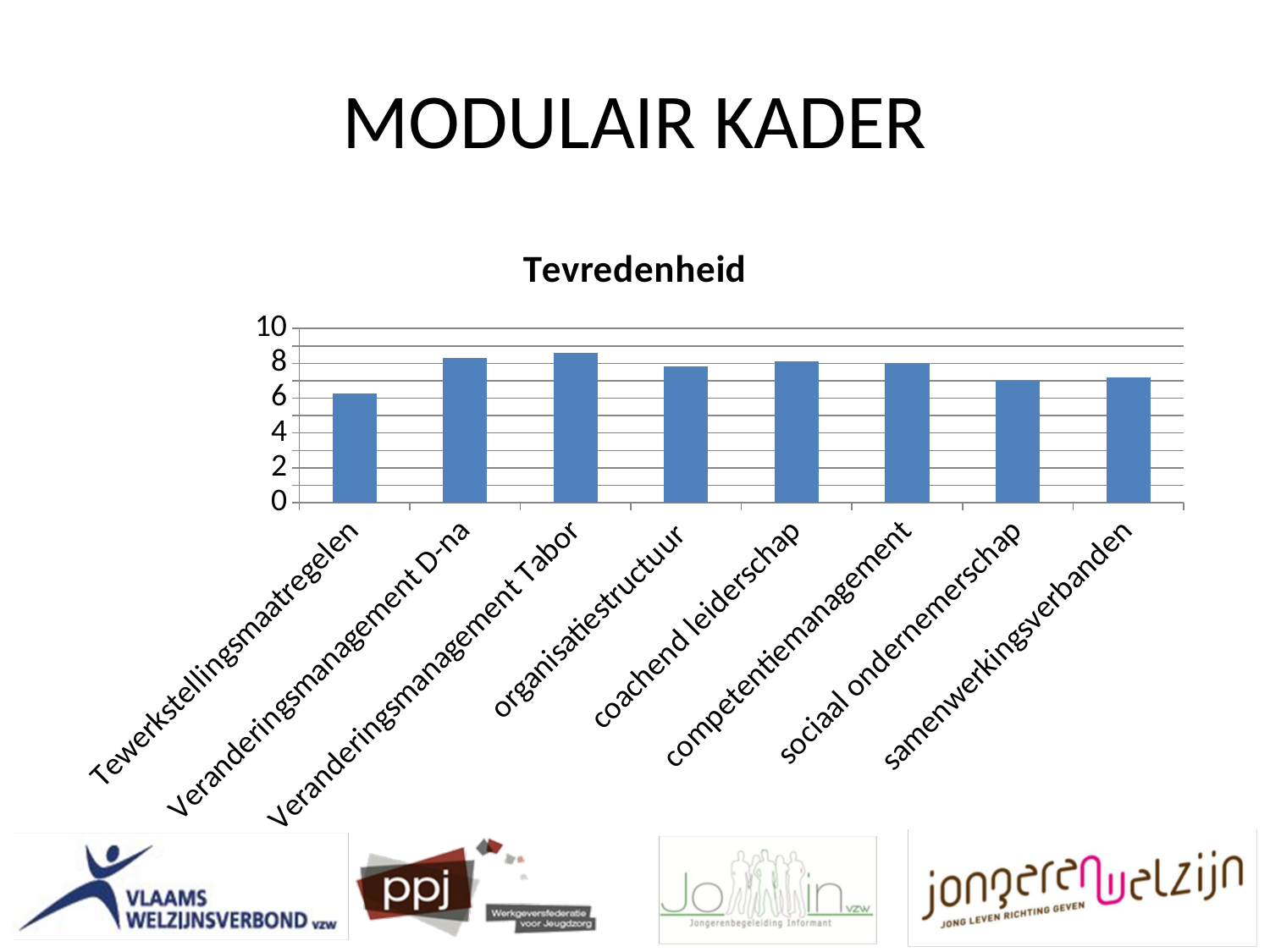
Which category has the lowest value in the chart? Tewerkstellingsmaatregelen Is the value for sociaal ondernemerschap greater or less than 8? less What is the title of the chart? Tevredenheid Is the value for samenwerkingsverbanden greater or less than 6? greater How many categories are shown on the x axis of the chart? 8 What is the maximum value shown on the y axis of the chart? 10 Is the value for Veranderingsmanagement Tabor greater or less than 8? greater Which category has the highest value in the chart? Veranderingsmanagement Tabor What kind of chart is shown on the slide? bar chart Which is larger, the value for Tewerkstellingsmaatregelen or the value for Veranderingsmanagement D-na? Veranderingsmanagement D-na